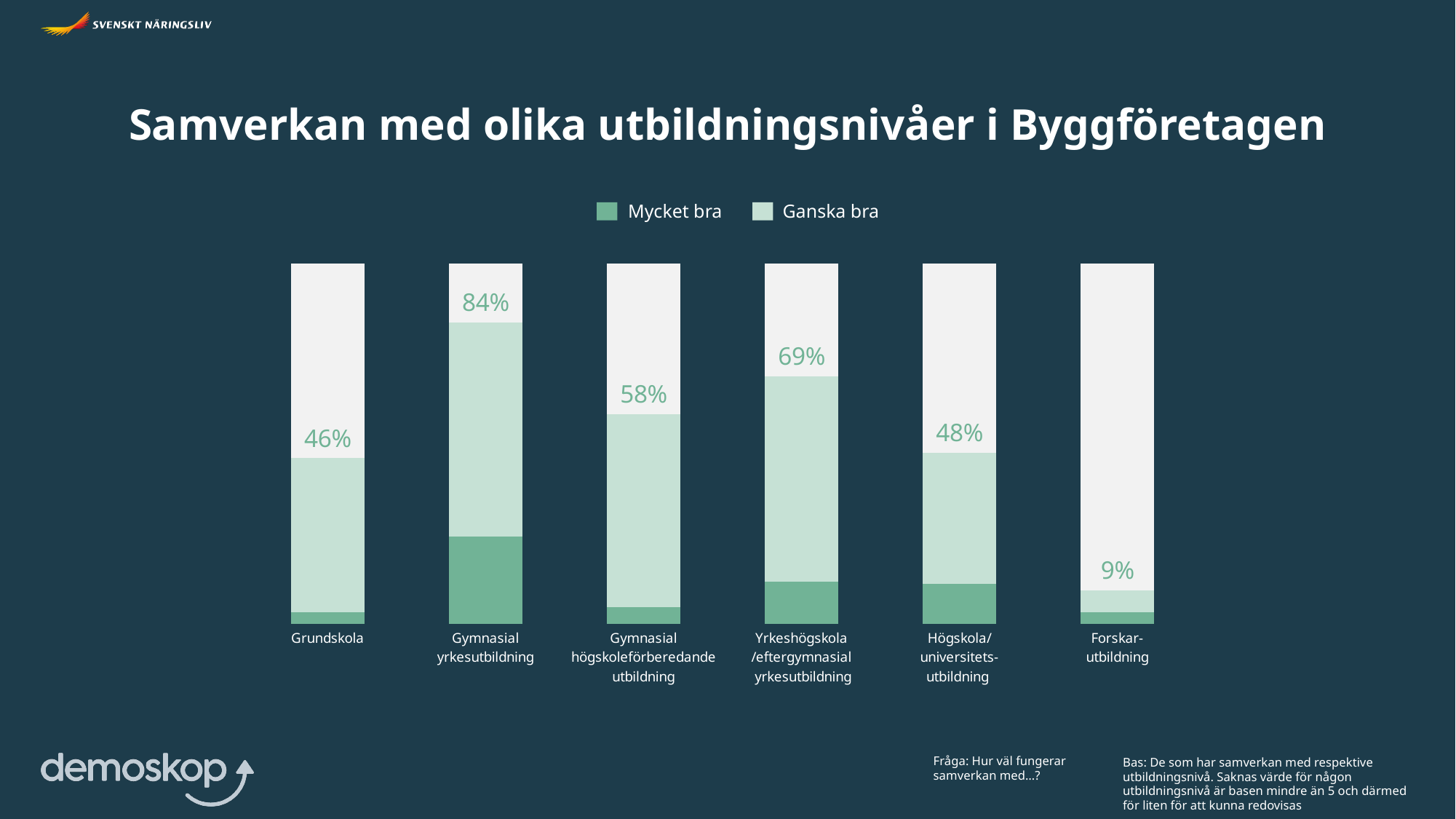
How many series does the legend list? 2 Which has a larger combined share, Högskola/universitetsutbildning or Yrkeshögskola/eftergymnasial yrkesutbildning? Yrkeshögskola/eftergymnasial yrkesutbildning What is the combined share shown for Gymnasial yrkesutbildning? 84% Which education level has the highest combined share? Gymnasial yrkesutbildning Which education level has the lowest combined share? Forskarutbildning What are the two series named in the legend? Mycket bra and Ganska bra What is the combined share shown for Yrkeshögskola/eftergymnasial yrkesutbildning? 69% What is the combined share shown for Grundskola? 46% What is the combined share shown for Forskarutbildning? 9% What is the difference between the combined shares for Gymnasial yrkesutbildning and Gymnasial högskoleförberedande utbildning? 26 percentage points How many education levels are shown on the chart? 6 What kind of chart is shown on the slide? Stacked bar chart